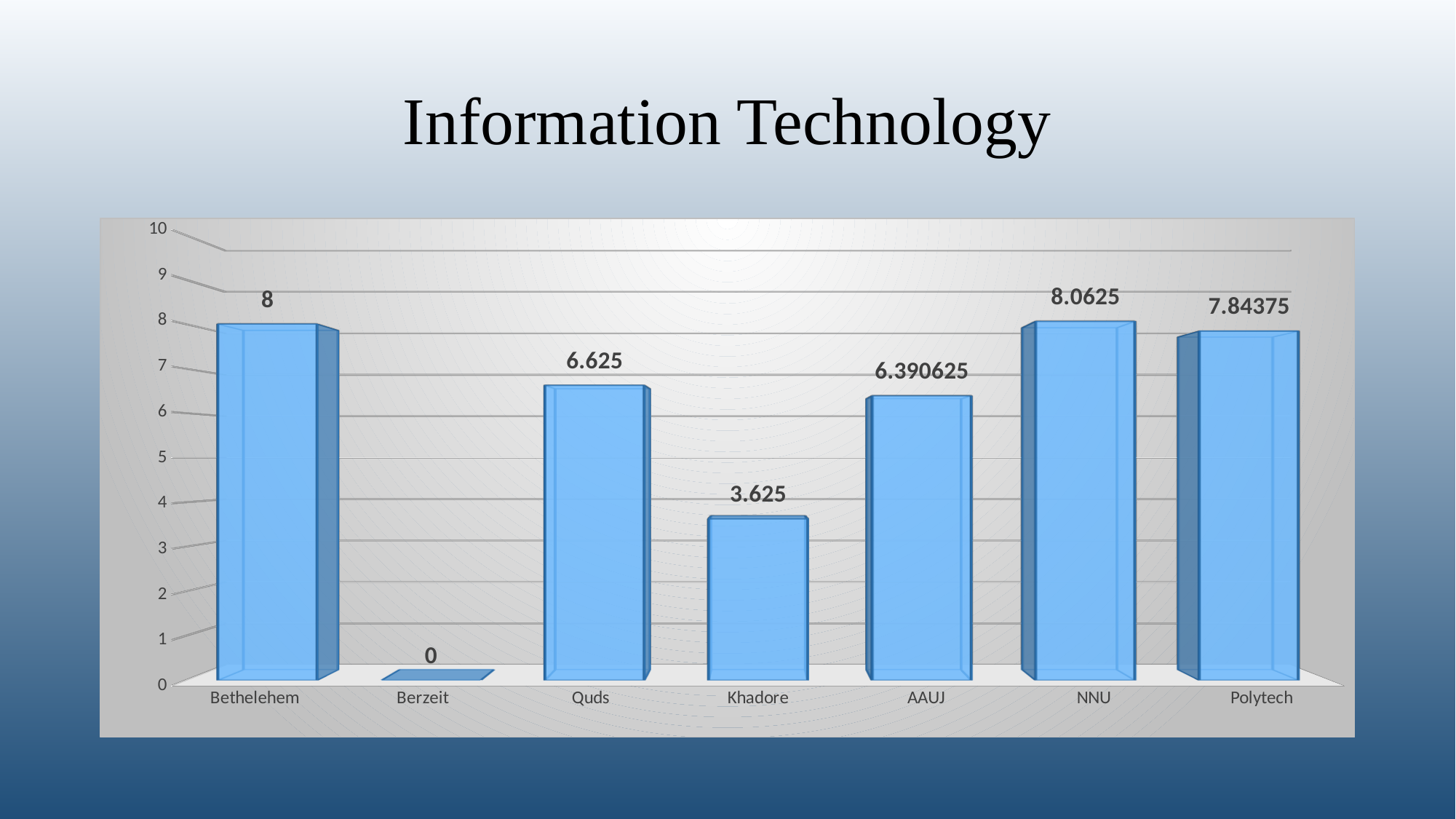
What is the value for Bethelehem? 8 What is the value for Khadore? 3.625 What is the value for Quds? 6.625 Which is larger, the value for Quds or the value for AAUJ? Quds What kind of chart is shown on the slide? Bar chart How many categories are shown on the x axis? 7 What is the difference between the values for NNU and Khadore? 4.4375 Which category has the highest value? NNU Which category has the lowest value? Berzeit What is the value for Polytech? 7.84375 What is the value for AAUJ? 6.390625 What is the title of the slide? Information Technology